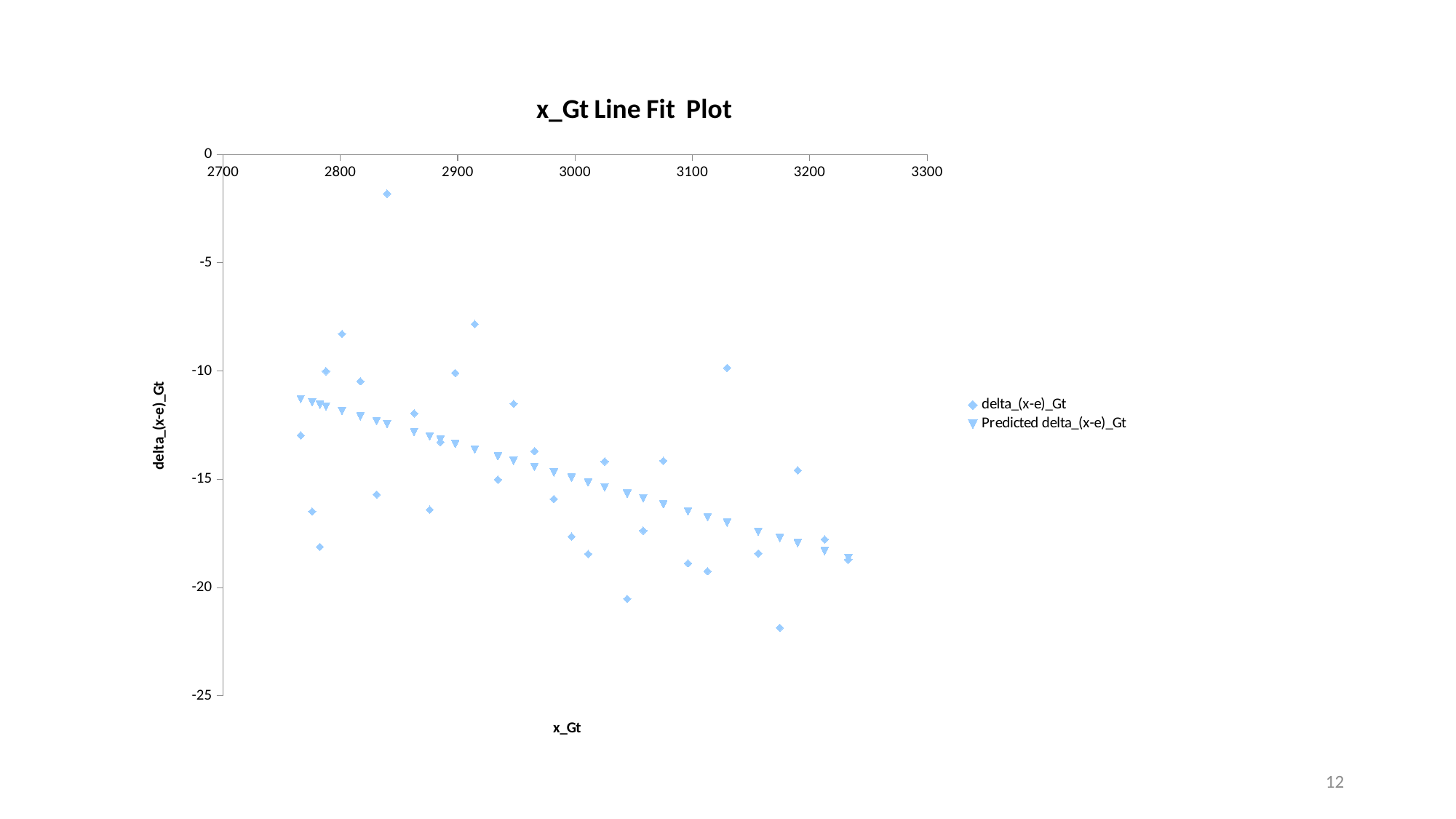
How many series does the legend list? 2 Is the Predicted delta_(x-e)_Gt value at x_Gt = 2900 greater or less than -15? greater What is the label on the vertical axis? delta_(x-e)_Gt Is the Predicted delta_(x-e)_Gt value at x_Gt = 2900 greater or less than -10? less Is the highest delta_(x-e)_Gt point on the chart greater or less than -5? greater Do the Predicted delta_(x-e)_Gt values rise or fall as x_Gt increases? fall Which series has the larger value at the leftmost x_Gt point (around 2765): delta_(x-e)_Gt or Predicted delta_(x-e)_Gt? Predicted delta_(x-e)_Gt What kind of chart is shown on the slide? scatter chart What is the title of the chart? x_Gt Line Fit Plot